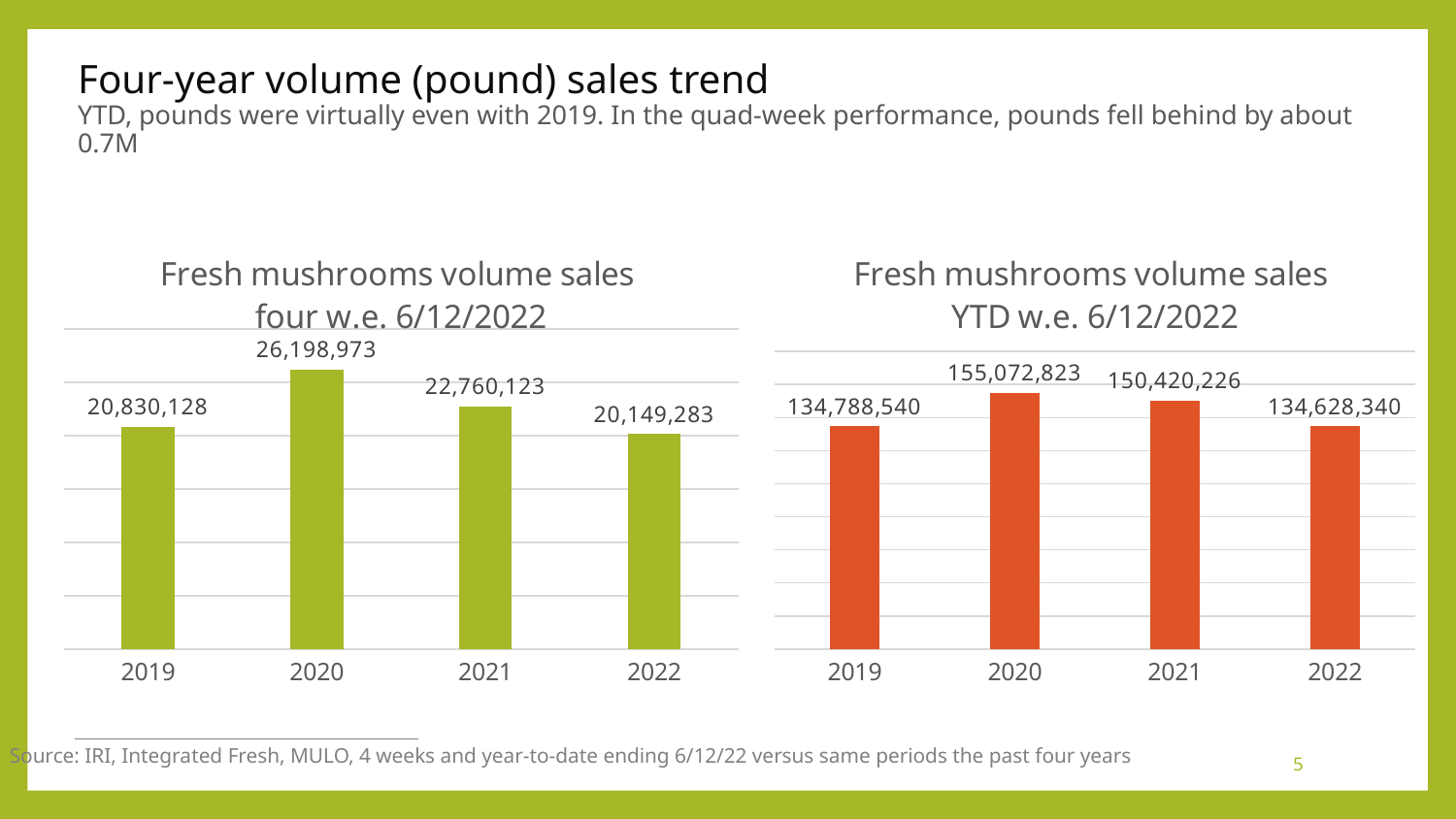
In the 'Fresh mushrooms volume sales YTD w.e. 6/12/2022' chart, which year has the highest value? 2020 In the 'Fresh mushrooms volume sales YTD w.e. 6/12/2022' chart, what is the difference between the 2020 and 2021 values? 4,652,597 What colour are the bars in the 'Fresh mushrooms volume sales YTD w.e. 6/12/2022' chart? Orange In the 'Fresh mushrooms volume sales four w.e. 6/12/2022' chart, what is the difference between the 2020 and 2019 values? 5,368,845 In the 'Fresh mushrooms volume sales four w.e. 6/12/2022' chart, what is the value for 2020? 26,198,973 In the 'Fresh mushrooms volume sales YTD w.e. 6/12/2022' chart, which is larger, the value for 2021 or the value for 2022? 2021 What kind of chart is the 'Fresh mushrooms volume sales YTD w.e. 6/12/2022' chart? Bar chart In the 'Fresh mushrooms volume sales four w.e. 6/12/2022' chart, do the values rise or fall from 2020 to 2022? Fall In the 'Fresh mushrooms volume sales four w.e. 6/12/2022' chart, which is larger, the value for 2021 or the value for 2019? 2021 In the 'Fresh mushrooms volume sales YTD w.e. 6/12/2022' chart, what is the value for 2022? 134,628,340 In the 'Fresh mushrooms volume sales four w.e. 6/12/2022' chart, which year has the lowest value? 2022 How many years are shown in the 'Fresh mushrooms volume sales four w.e. 6/12/2022' chart? 4